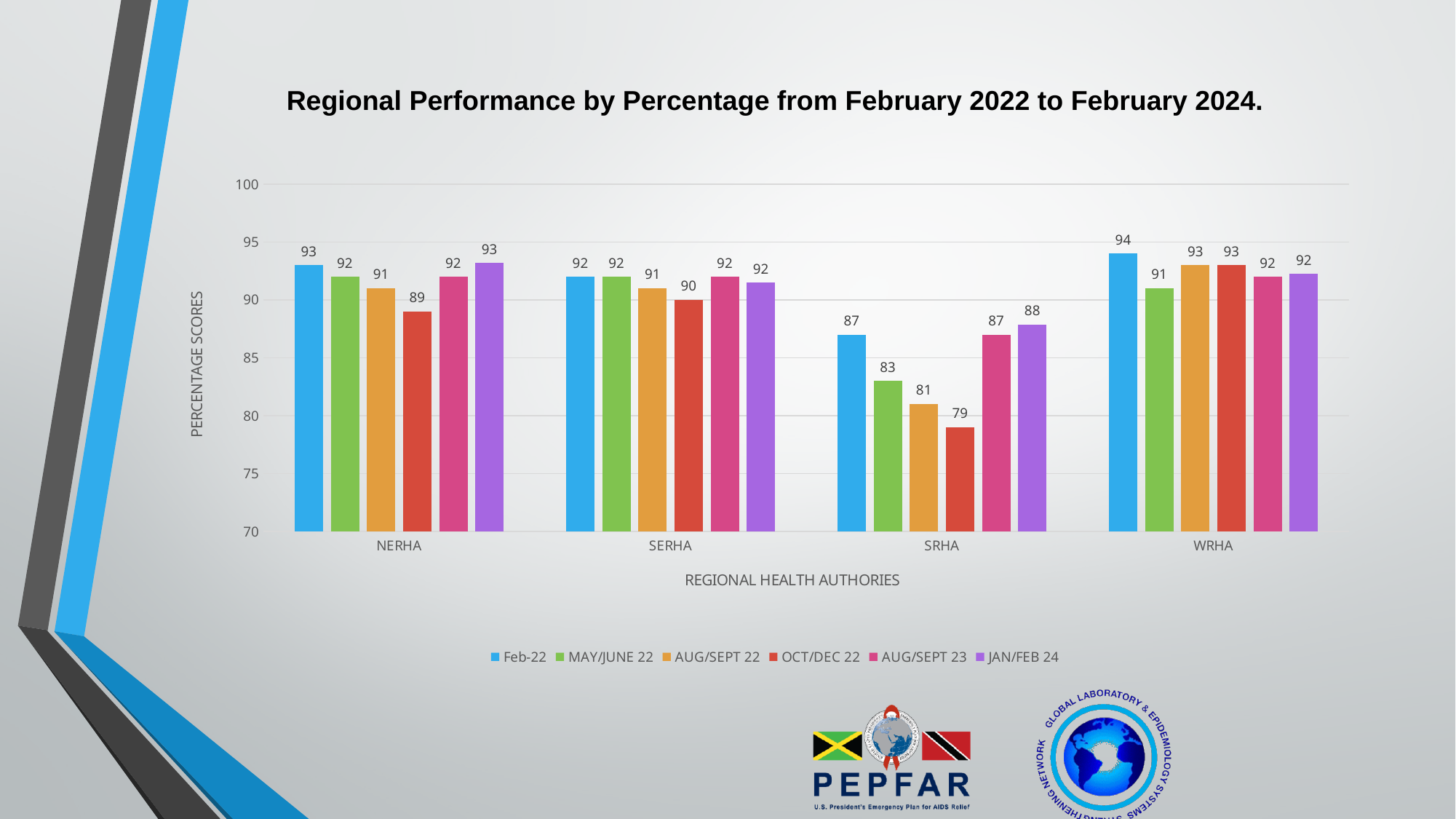
Which regional health authority has the lowest OCT/DEC 22 value? SRHA How many series does the legend list? 6 What is the Feb-22 value for NERHA? 93 How many regional health authorities are shown on the x axis? 4 What is the JAN/FEB 24 value for WRHA? 92 Which is larger for SERHA: the AUG/SEPT 22 value or the OCT/DEC 22 value? AUG/SEPT 22 What is the title of the chart? Regional Performance by Percentage from February 2022 to February 2024. What kind of chart is shown on the slide? Bar chart What is the difference between the JAN/FEB 24 value and the OCT/DEC 22 value for SRHA? 9 What is the label of the y axis? PERCENTAGE SCORES What is the OCT/DEC 22 value for SRHA? 79 Which regional health authority has the highest Feb-22 value? WRHA